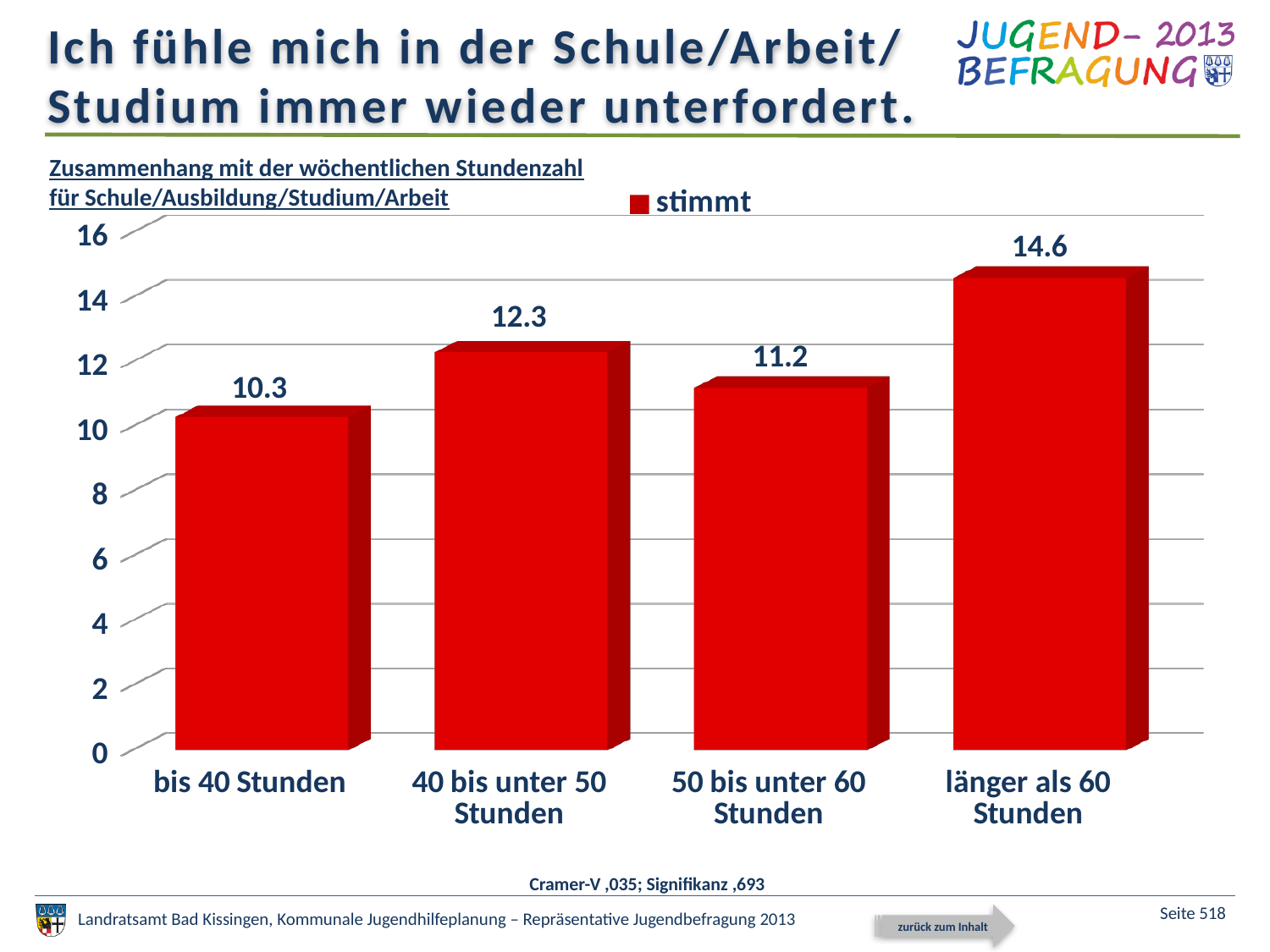
Which is larger, the value for "40 bis unter 50 Stunden" or for "50 bis unter 60 Stunden"? 40 bis unter 50 Stunden How many series does the legend list? 1 What is the value for "40 bis unter 50 Stunden"? 12.3 What is the value for "bis 40 Stunden"? 10.3 What kind of chart is shown on the slide? bar chart Which category has the highest value? länger als 60 Stunden What is the value for "länger als 60 Stunden"? 14.6 What is the value for "50 bis unter 60 Stunden"? 11.2 Which category has the lowest value? bis 40 Stunden What is the legend entry of the series shown? stimmt How many categories are shown on the x axis? 4 What is the difference between the values for "länger als 60 Stunden" and "bis 40 Stunden"? 4.3